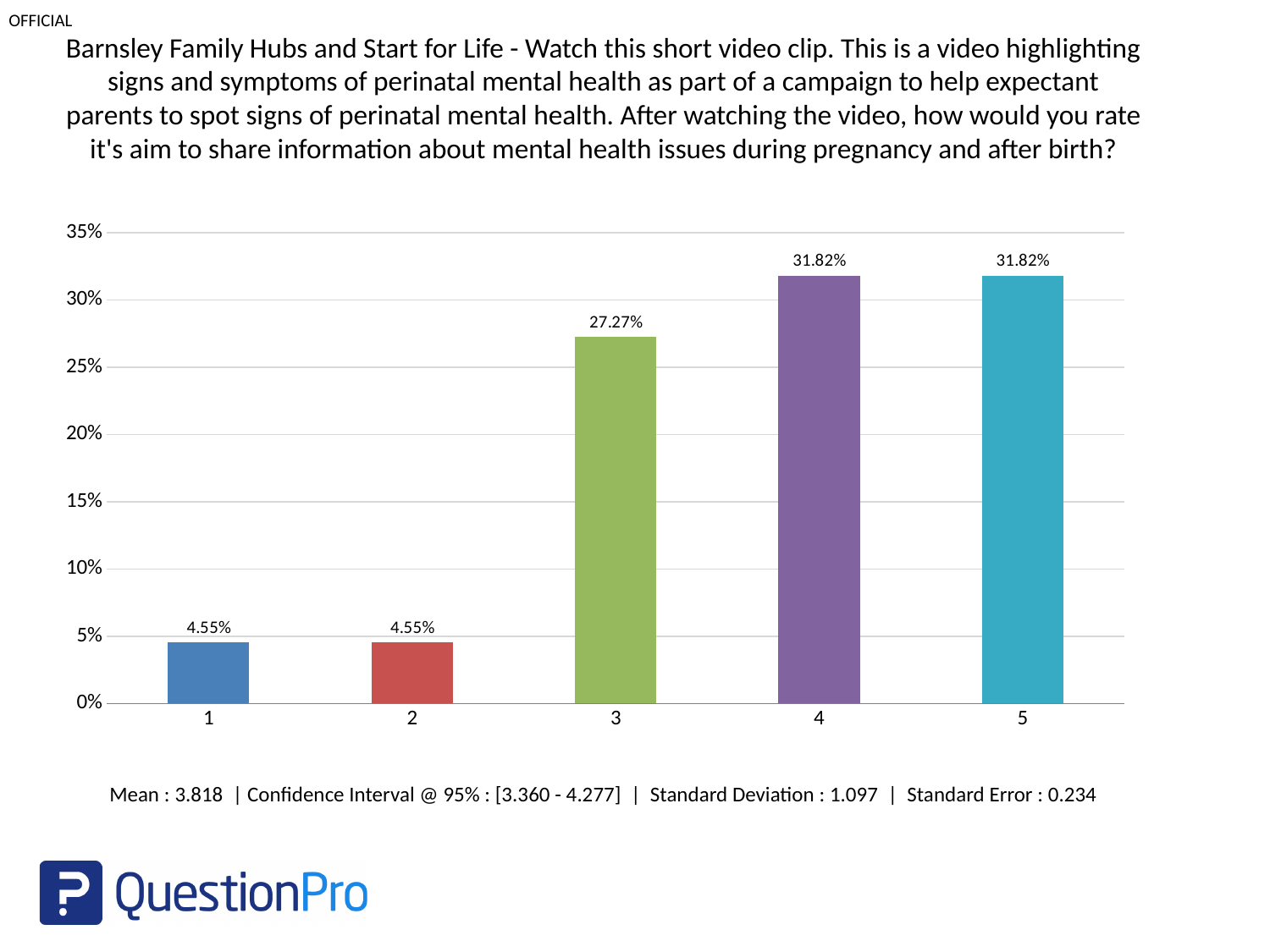
What kind of chart is shown on the slide? bar chart Which categories share the highest value? 4 and 5 What mean value is reported below the chart? 3.818 What is the difference between the values for category 3 and category 2? 22.72% What is the value for category 1? 4.55% What is the value for category 3? 27.27% What is the difference between the values for category 4 and category 3? 4.55% Which is larger, the value for category 3 or the value for category 1? 3 Which categories have the lowest value? 1 and 2 How many categories are shown on the x axis? 5 What is the value for category 5? 31.82% Is the value for category 3 greater or less than 25%? greater